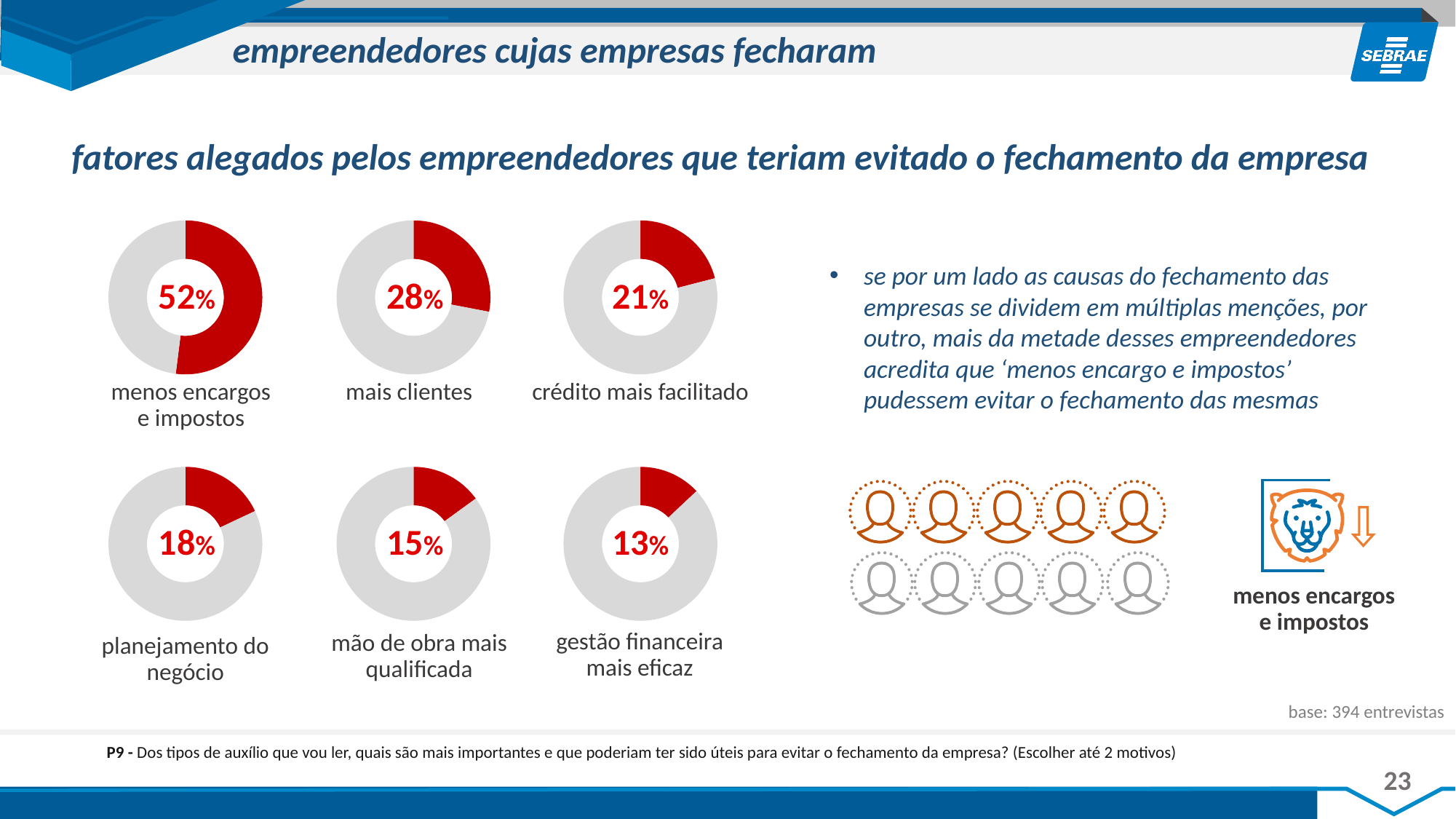
What percentage is shown in the donut chart labelled 'menos encargos e impostos'? 52% What percentage is shown in the donut chart labelled 'planejamento do negócio'? 18% What is the difference in percentage points between 'menos encargos e impostos' and 'mais clientes'? 24 What percentage is shown in the donut chart labelled 'gestão financeira mais eficaz'? 13% What type of chart is used to display each factor's percentage? donut chart Which factor has the lowest percentage among the six donut charts? gestão financeira mais eficaz Which factor has the highest percentage among the six donut charts? menos encargos e impostos What percentage is shown in the donut chart labelled 'crédito mais facilitado'? 21% What percentage is shown in the donut chart labelled 'mão de obra mais qualificada'? 15% What percentage is shown in the donut chart labelled 'mais clientes'? 28% Which has a larger percentage, 'crédito mais facilitado' or 'planejamento do negócio'? crédito mais facilitado How many donut charts are shown on the slide? 6